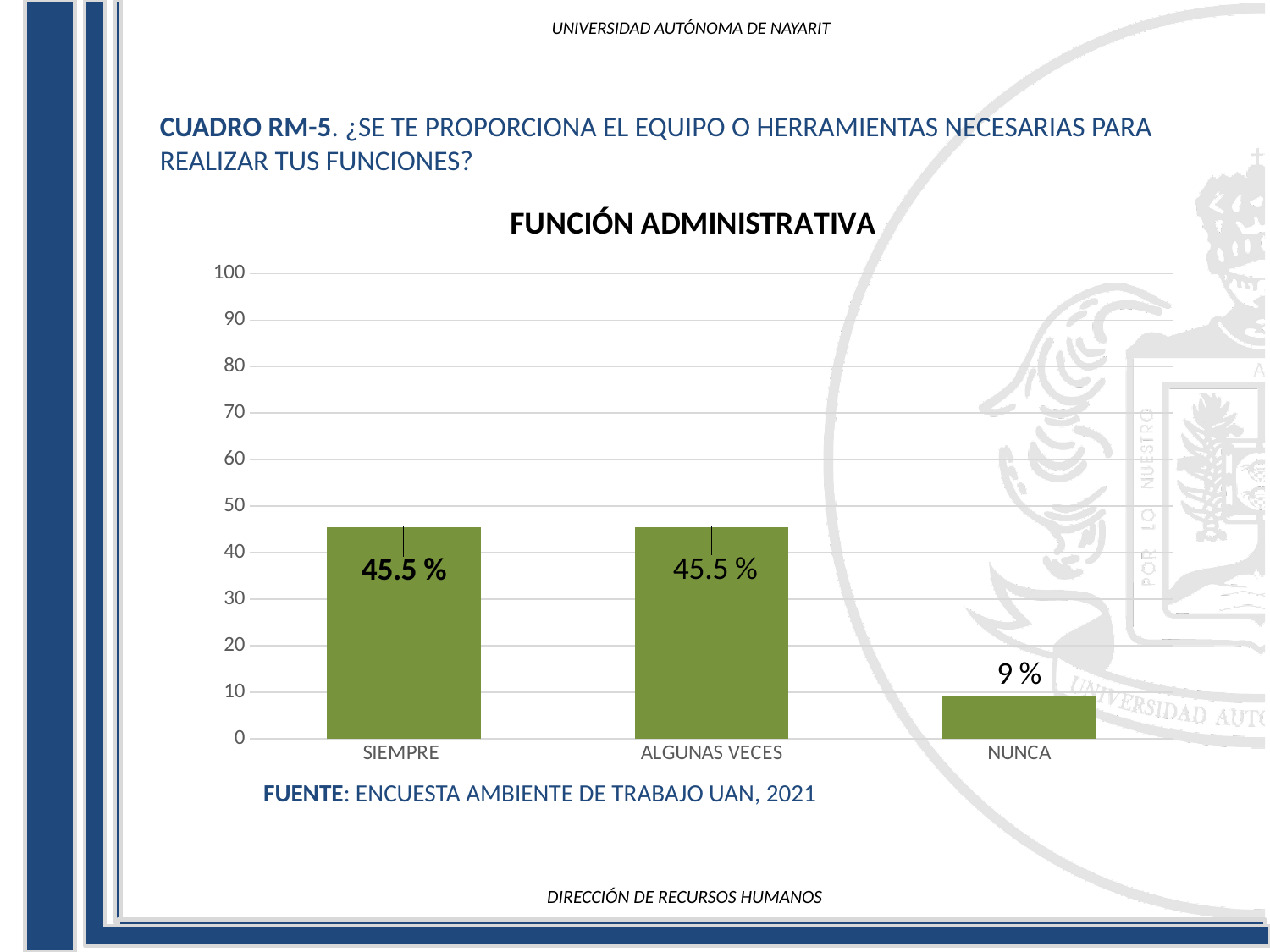
Is the value for SIEMPRE greater or less than 40? greater What kind of chart is shown on the slide? bar chart What is the difference between the value for ALGUNAS VECES and the value for NUNCA? 36.5 % How many categories are shown on the x axis? 3 What is the value for SIEMPRE? 45.5 % Is the value for NUNCA greater or less than 20? less Which category has the lowest value? NUNCA Which is larger, the value for SIEMPRE or the value for NUNCA? SIEMPRE What is the value for ALGUNAS VECES? 45.5 % What is the value for NUNCA? 9 % What is the title of the chart? FUNCIÓN ADMINISTRATIVA What is the highest value shown on the y axis? 100